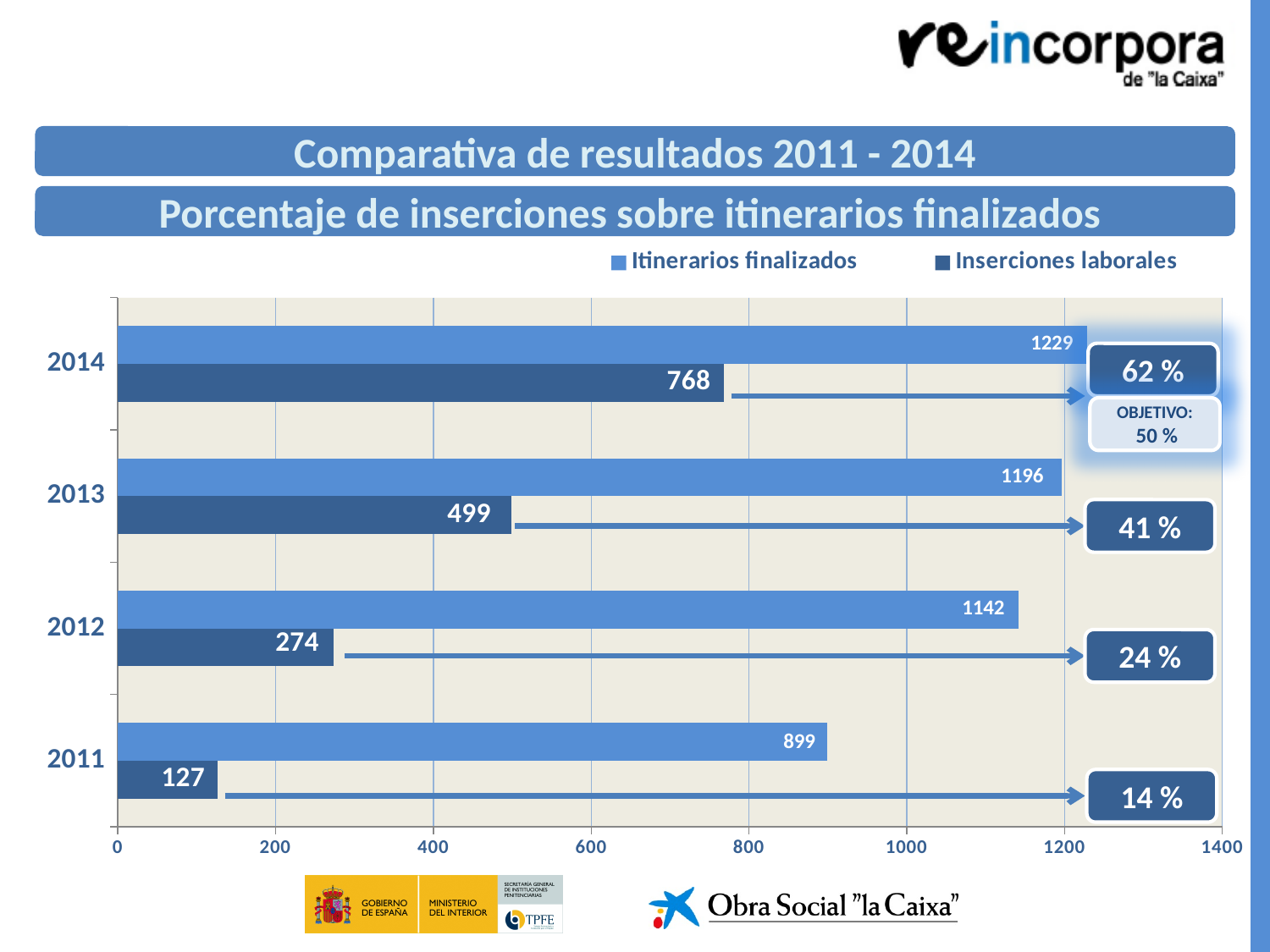
How many years are shown on the chart? 4 What is the value of Inserciones laborales for 2012? 274 What is the difference between Itinerarios finalizados and Inserciones laborales in 2013? 697 What percentage is shown next to the 2013 bars? 41 % What is the value of Itinerarios finalizados for 2014? 1229 Which year has the lowest value for Itinerarios finalizados? 2011 Which is larger: Inserciones laborales in 2013 or Inserciones laborales in 2012? 2013 How many series does the legend list? 2 Which year has the highest value for Inserciones laborales? 2014 What is the value of Inserciones laborales for 2011? 127 Is the value of Itinerarios finalizados for 2012 greater or less than 1000? greater What kind of chart is shown on the slide? Bar chart